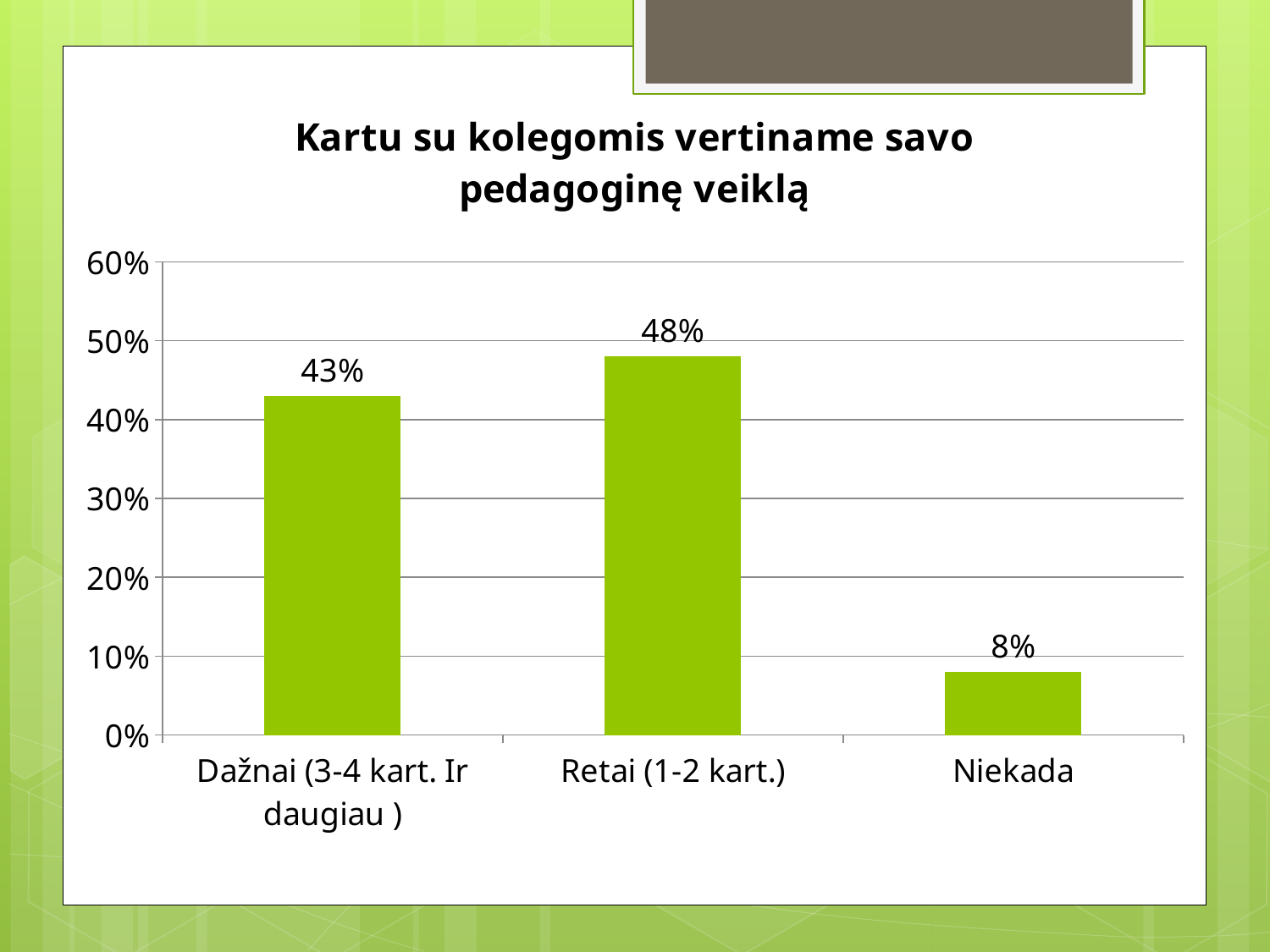
What is the value for Dažnai (3-4 kart. Ir daugiau )? 43% Which is larger, the value for Dažnai (3-4 kart. Ir daugiau ) or the value for Niekada? Dažnai (3-4 kart. Ir daugiau ) What is the value for Niekada? 8% What is the title of the chart? Kartu su kolegomis vertiname savo pedagoginę veiklą What is the value for Retai (1-2 kart.)? 48% Is the value for Retai (1-2 kart.) greater or less than 40%? greater What is the difference between the values for Dažnai (3-4 kart. Ir daugiau ) and Niekada? 35% How many categories are shown on the x axis? 3 What kind of chart is shown on the slide? bar chart What is the difference between the values for Retai (1-2 kart.) and Dažnai (3-4 kart. Ir daugiau )? 5% Which category has the highest value? Retai (1-2 kart.) Which category has the lowest value? Niekada